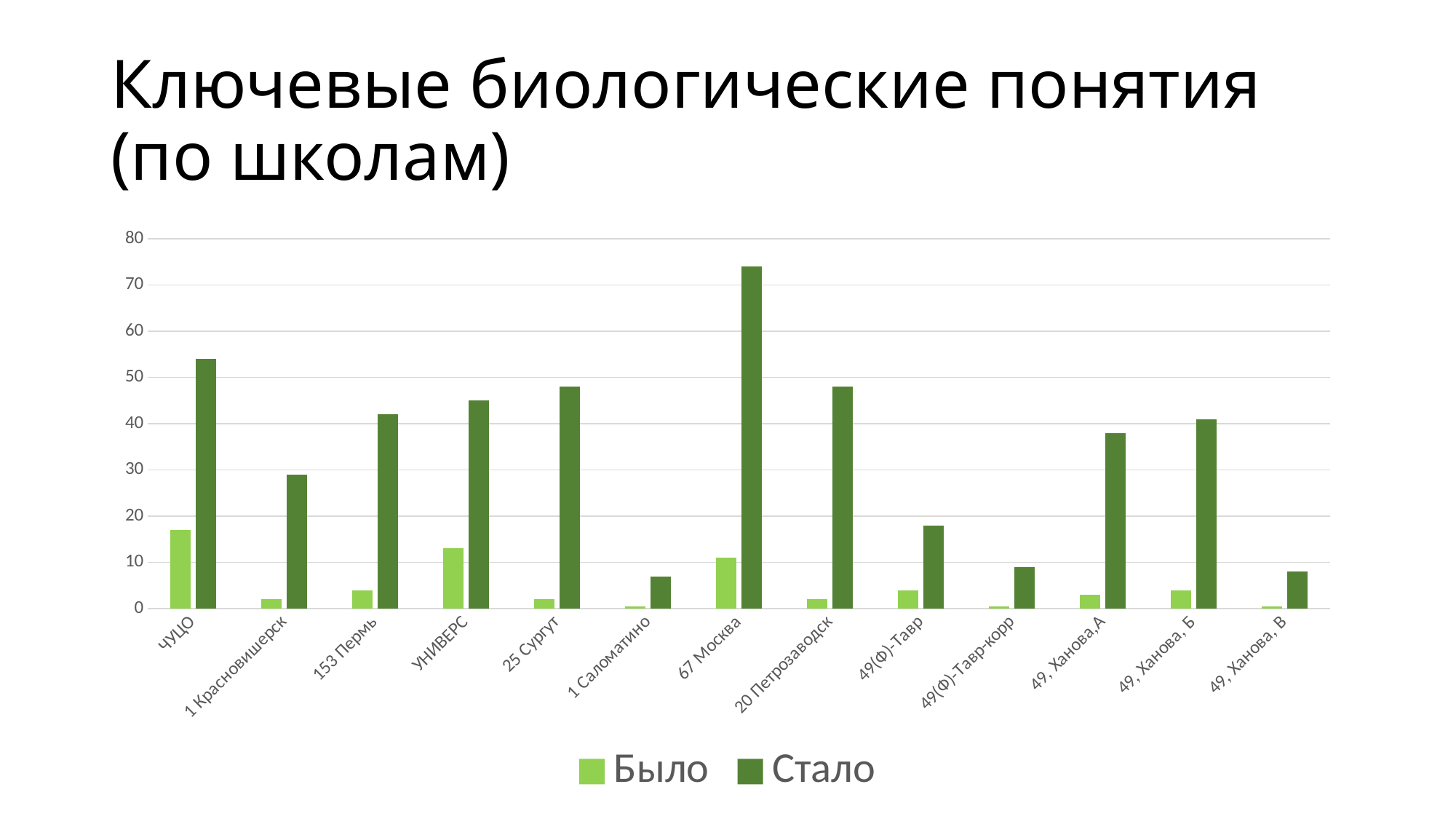
Is the Было value for УНИВЕРС greater or less than 10? greater Is the Стало value for 67 Москва greater or less than 70? greater Which school has the highest value for the Было series? ЧУЦО How many series does the legend list? 2 Which is larger: the Стало value for ЧУЦО or the Стало value for 25 Сургут? ЧУЦО Is the Стало value for ЧУЦО greater or less than 50? greater Which school has the highest value for the Стало series? 67 Москва Which is larger: the Стало value for 20 Петрозаводск or the Стало value for 49(Ф)-Тавр? 20 Петрозаводск What are the two series names listed in the legend? Было and Стало How many schools (categories) are shown on the x axis? 13 What kind of chart is shown on the slide? bar chart